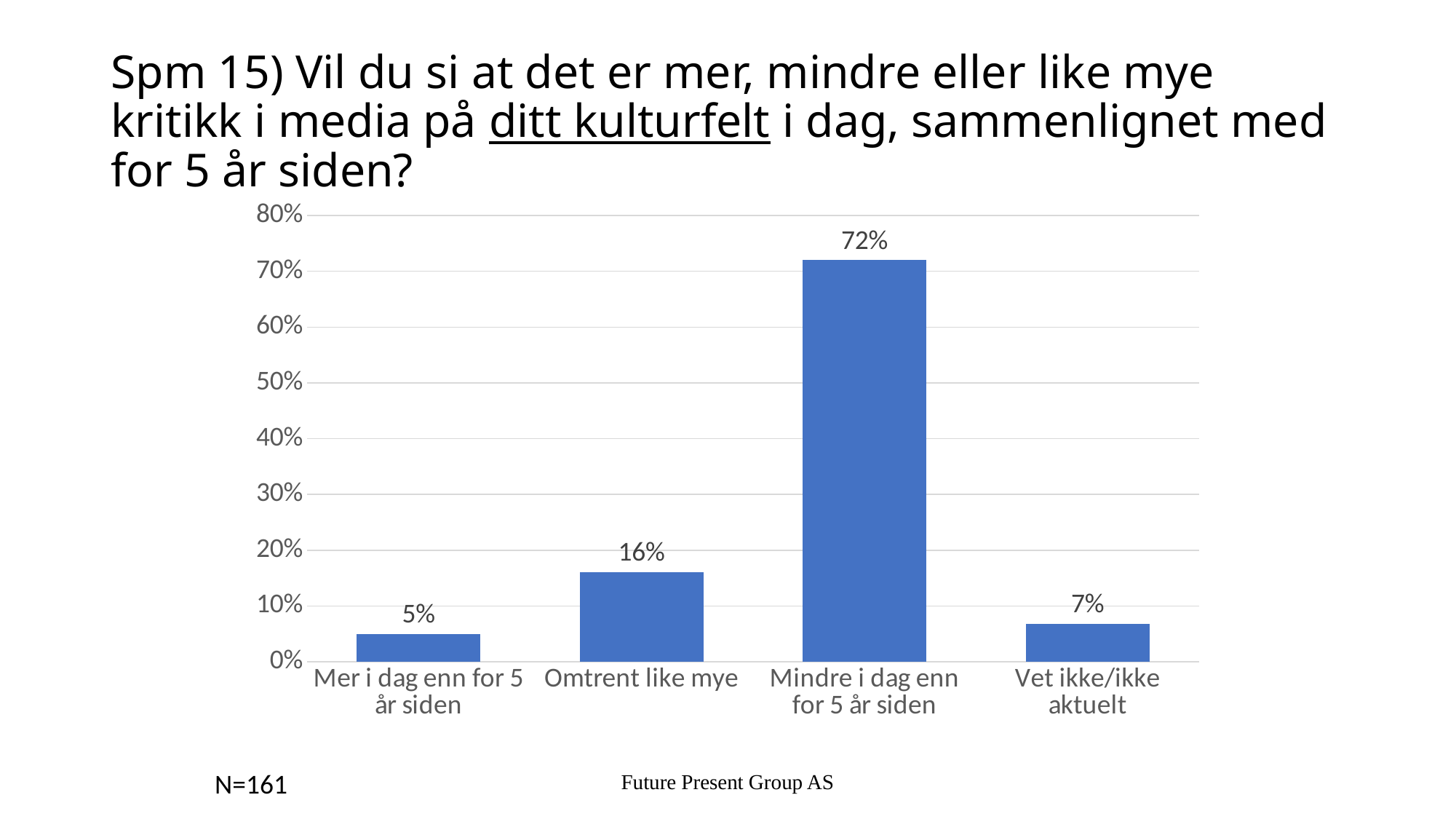
What is the value for "Mindre i dag enn for 5 år siden"? 72% Which category has the lowest value? Mer i dag enn for 5 år siden What is the value for "Vet ikke/ikke aktuelt"? 7% Is the value for "Mindre i dag enn for 5 år siden" greater or less than 70%? greater How many categories are shown on the x axis? 4 What is the value for "Omtrent like mye"? 16% What sample size (N) is stated on the slide? N=161 Which is larger, the value for "Vet ikke/ikke aktuelt" or the value for "Mer i dag enn for 5 år siden"? Vet ikke/ikke aktuelt Which category has the highest value? Mindre i dag enn for 5 år siden What is the value for "Mer i dag enn for 5 år siden"? 5% What kind of chart is shown on the slide? Bar chart What is the difference between the values for "Mindre i dag enn for 5 år siden" and "Omtrent like mye"? 56%